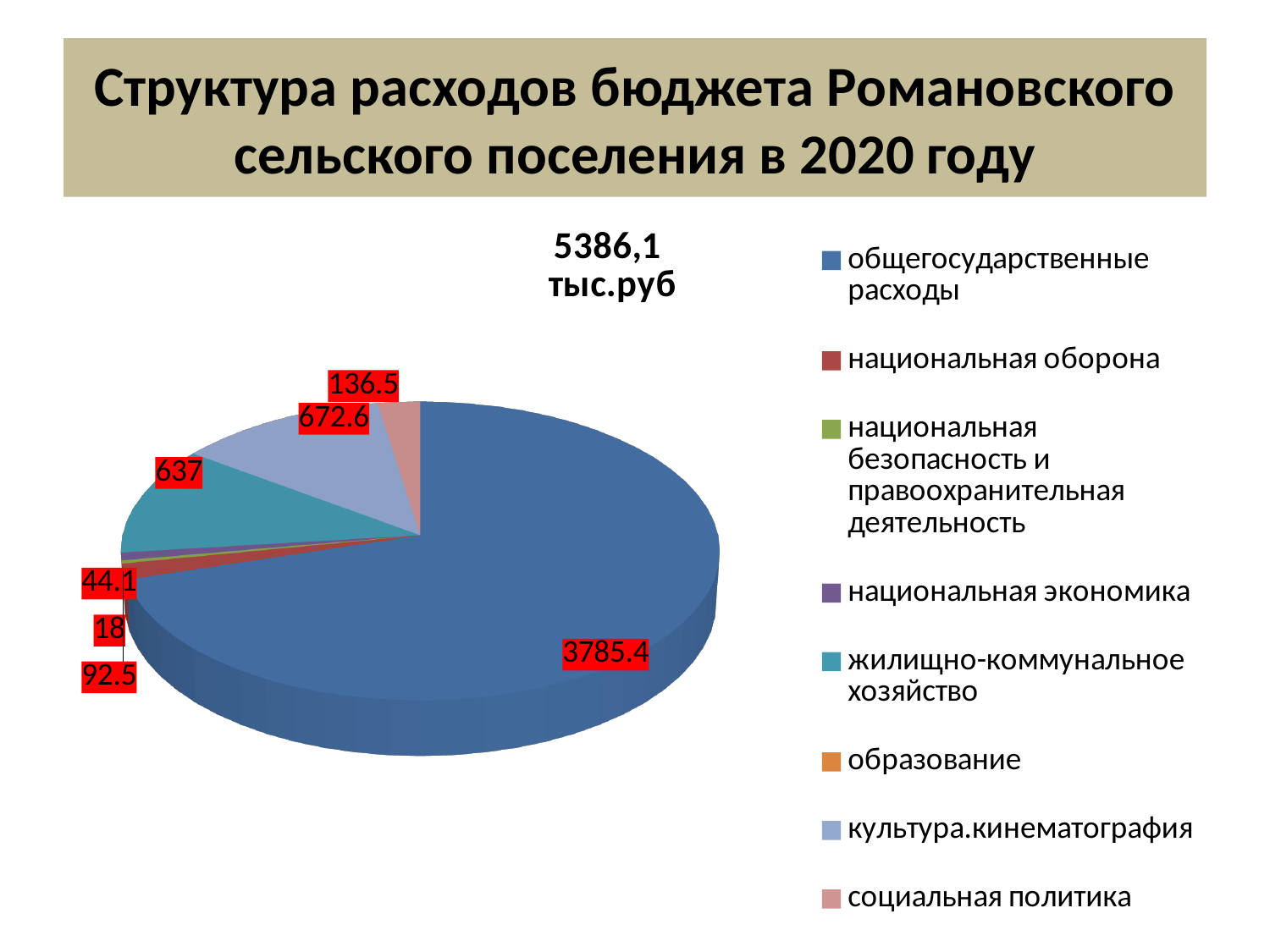
Which category has the largest slice of the pie? общегосударственные расходы What is the value shown for национальная оборона? 92.5 Which is larger: социальная политика or жилищно-коммунальное хозяйство? жилищно-коммунальное хозяйство How many categories does the legend list? 8 What is the value shown for жилищно-коммунальное хозяйство? 637 What is the value shown for культура.кинематография? 672.6 Which is larger: культура.кинематография or жилищно-коммунальное хозяйство? культура.кинематография What is the value shown for общегосударственные расходы? 3785.4 What type of chart is shown on the slide? pie chart What is the value shown for социальная политика? 136.5 What total amount is shown in the chart's title? 5386,1 тыс.руб What is the difference between the values for культура.кинематография and жилищно-коммунальное хозяйство? 35.6